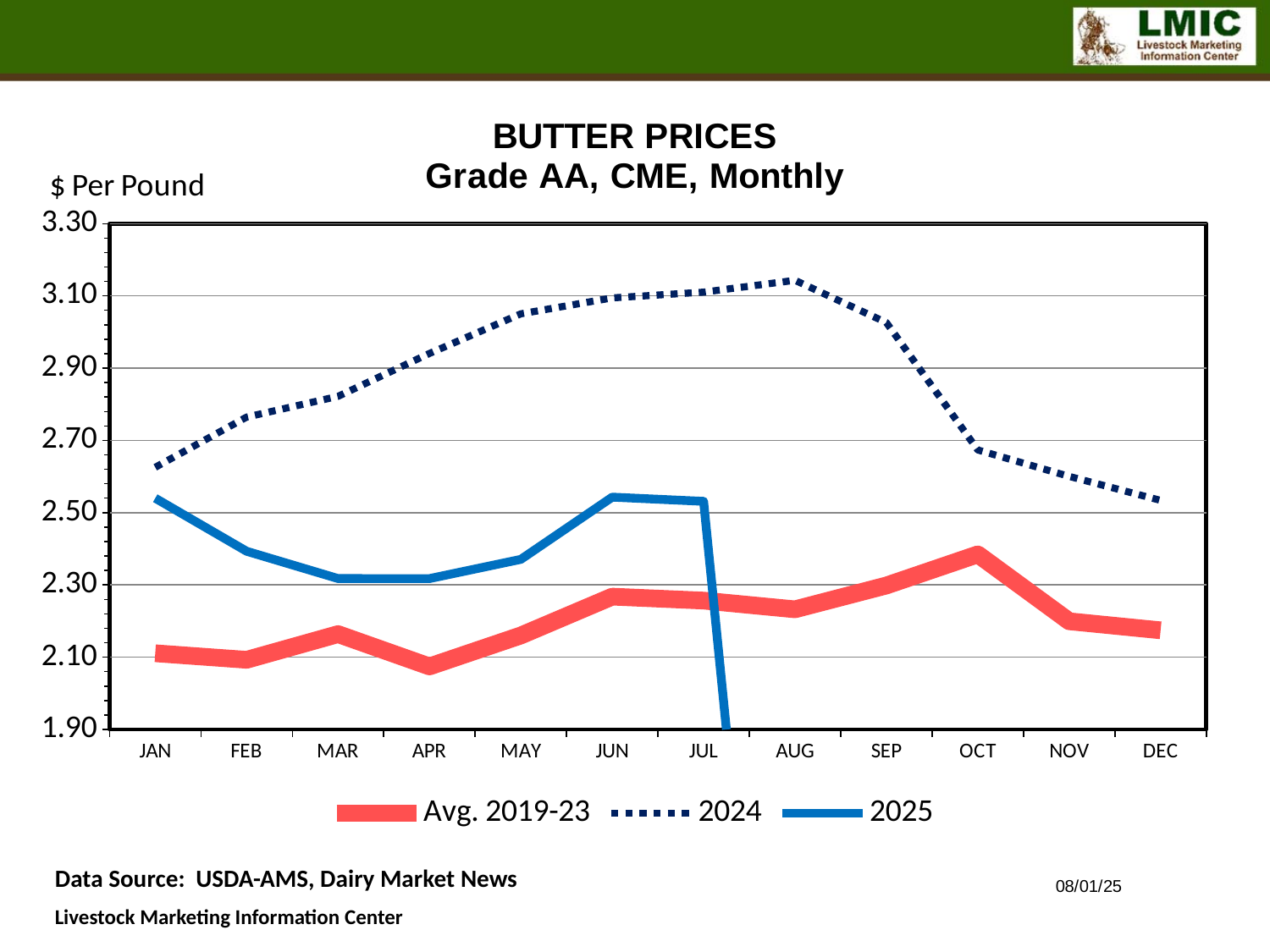
Is the 2024 value for MAY greater or less than 2.90? greater In which month does the Avg. 2019-23 series reach its highest value? OCT In JUN, which series has the higher value, 2024 or Avg. 2019-23? 2024 Does the 2024 series rise or fall from JAN to AUG? rise In JAN, which series has the higher value, 2025 or Avg. 2019-23? 2025 How many series does the legend list? 3 Is the 2024 value for JAN greater or less than 2.70? less Is the Avg. 2019-23 value for JAN greater or less than 2.30? less What is the label on the y axis of the chart? $ Per Pound What kind of chart is shown on the slide? line chart How many months are shown along the x axis? 12